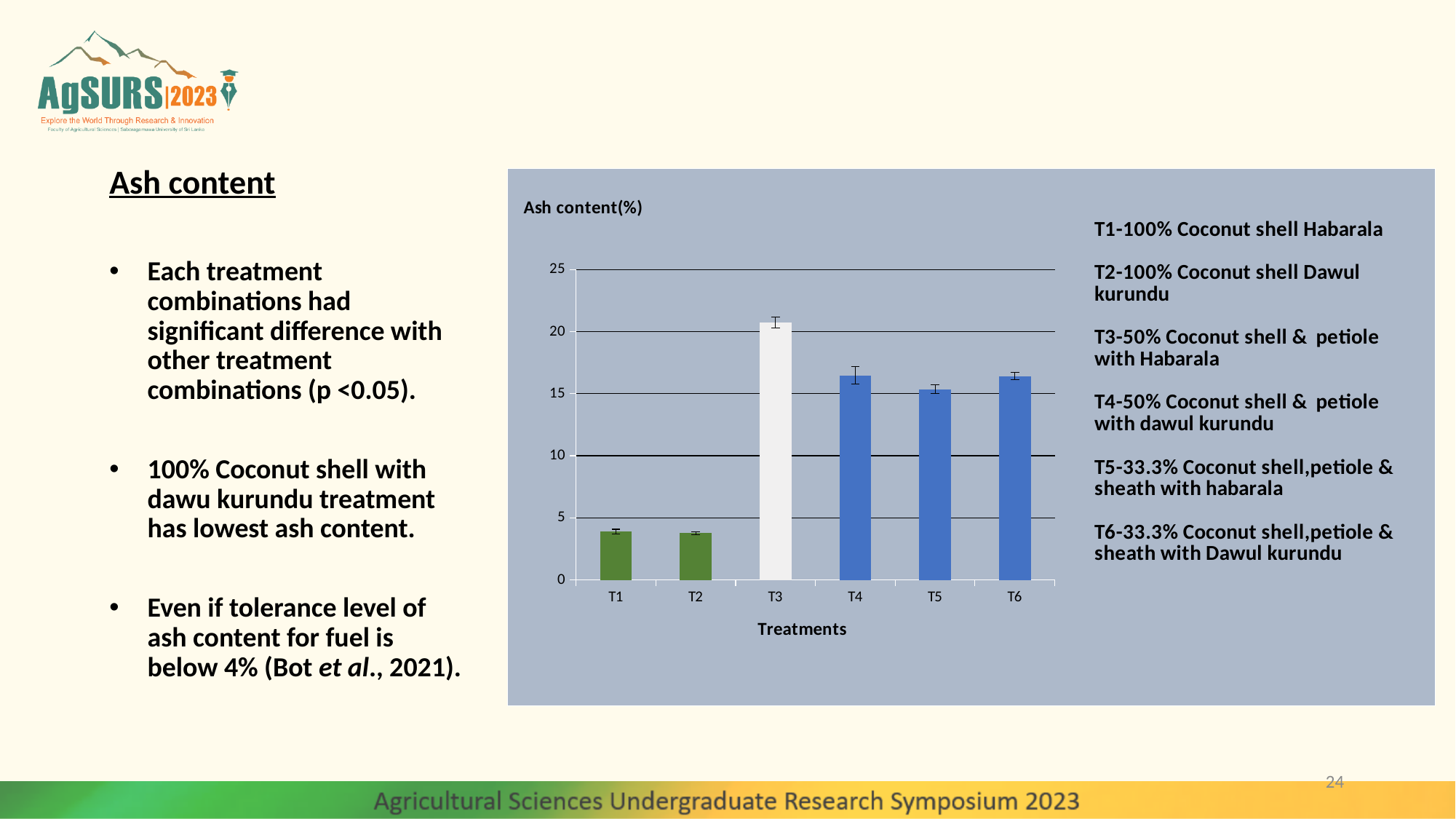
What is the label on the x axis of the chart? Treatments Is the ash content for T2 greater or less than 5? less How many treatments are plotted on the x axis of the chart? 6 Which has a higher ash content, T3 or T4? T3 Which treatment has the highest ash content in the chart? T3 Is the ash content for T4 greater or less than 15? greater Is the ash content for T1 greater or less than 5? less Which has a higher ash content, T1 or T6? T6 What is the label on the y axis of the chart? Ash content(%) What kind of chart is shown on the slide? bar chart